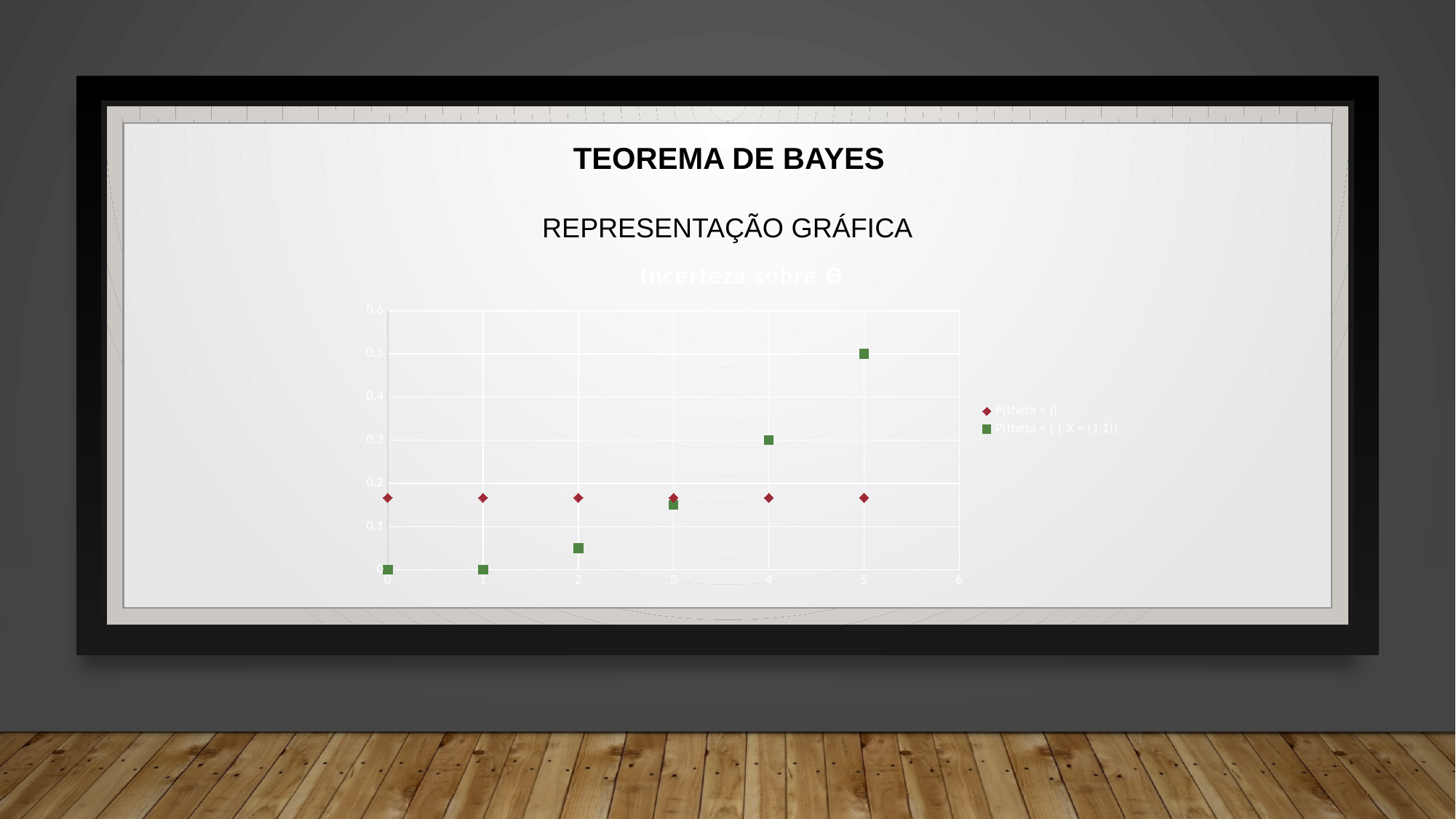
What is the title of the chart? Incerteza sobre Θ What is the value of P(theta = j | X = (1,1)) at x = 5? 0.5 At x = 2, which series has the larger value, P(theta = j) or P(theta = j | X = (1,1))? P(theta = j) Which series is plotted with green square markers? P(theta = j | X = (1,1)) How many data points does the P(theta = j) series have? 6 How many series does the chart's legend list? 2 At which x value is P(theta = j | X = (1,1)) highest? 5 Do the values of P(theta = j | X = (1,1)) rise or fall as x increases? rise Is the value of P(theta = j) at x = 3 greater or less than 0.1? greater Is the value of P(theta = j) at x = 0 greater or less than 0.2? less What is the value of P(theta = j | X = (1,1)) at x = 4? 0.3 What kind of chart is shown on the slide? scatter chart